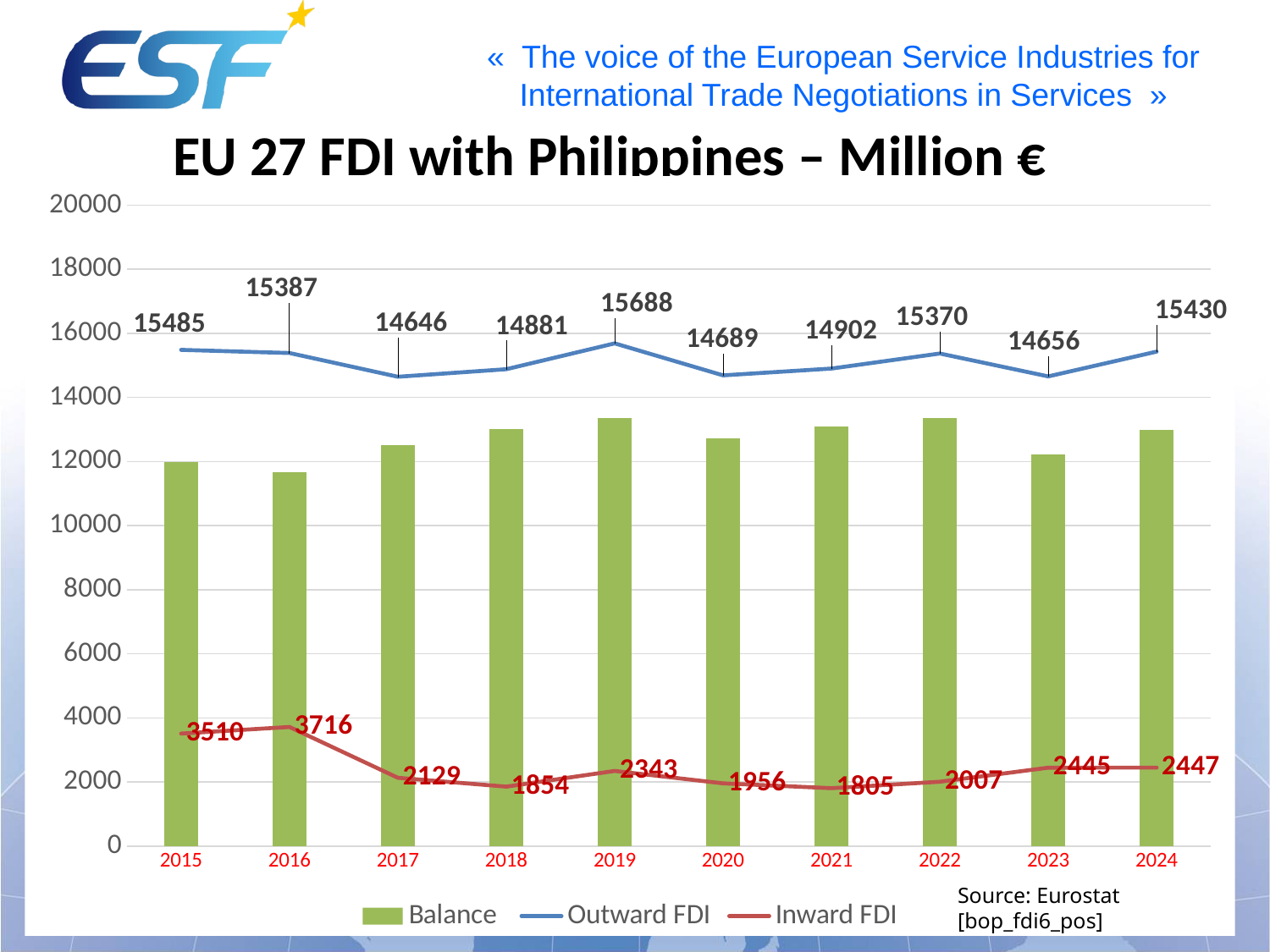
In which year is Inward FDI lowest? 2021 What is the difference between Outward FDI and Inward FDI in 2024? 12983 What kind of chart is this? Combined bar and line chart Is the Balance value for 2019 greater or less than 12000? greater Is the Balance value for 2016 greater or less than 12000? less Does Inward FDI rise or fall from 2016 to 2018? fall What is the Inward FDI value for 2017? 2129 What is the Outward FDI value for 2019? 15688 How many years are shown on the x axis? 10 In which year is Outward FDI highest? 2019 Which is larger, Inward FDI in 2015 or in 2016? 2016 How many series does the legend list? 3